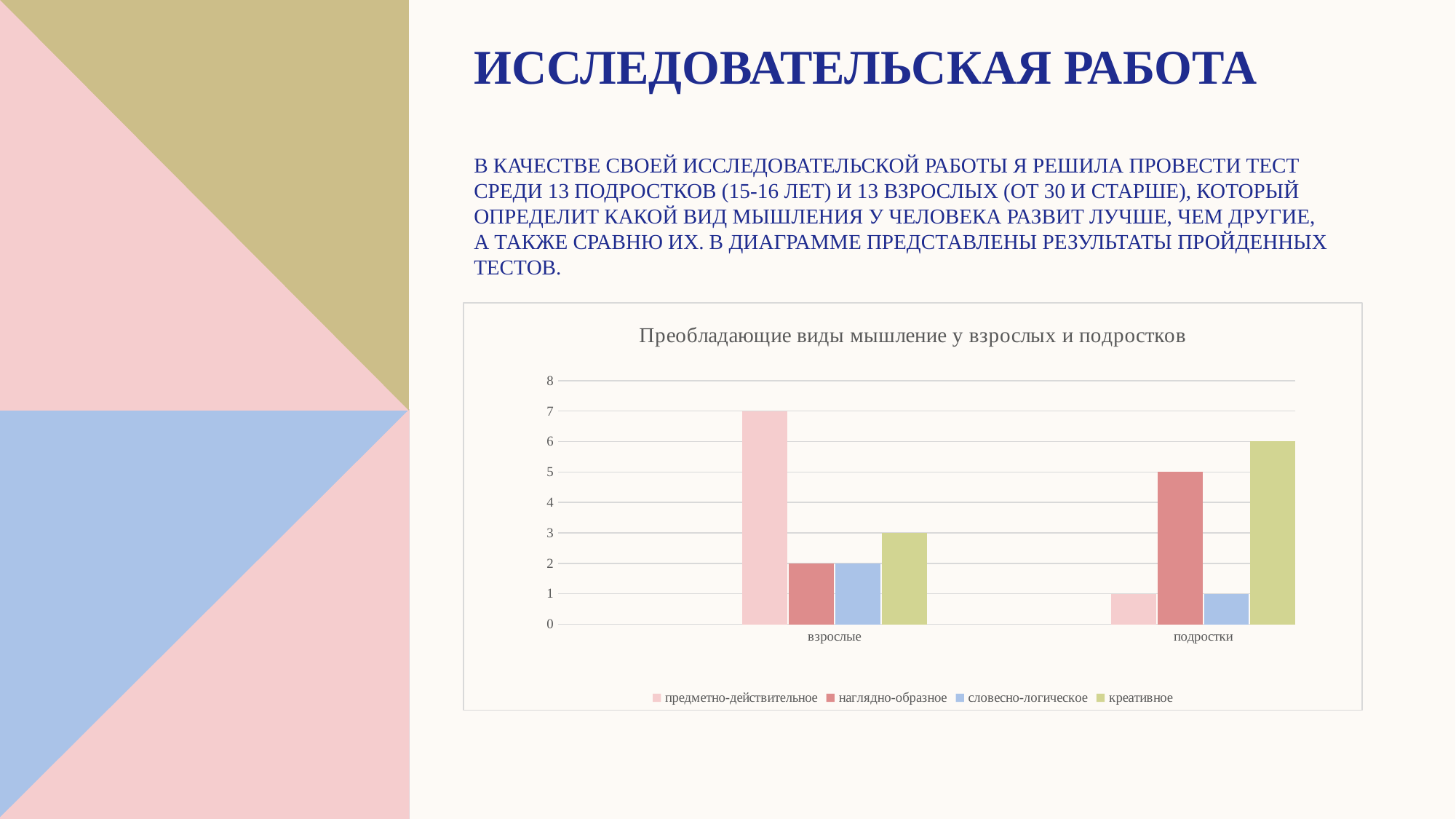
What is the difference between the предметно-действительное values for взрослые and подростки? 6 Which series has the highest value in the подростки category? креативное What kind of chart is shown on the slide? bar chart How many series does the chart legend list? 4 Which is larger: наглядно-образное for взрослые or наглядно-образное for подростки? подростки How many categories are shown on the x axis of the chart? 2 What is the value for креативное in the подростки category? 6 What is the title of the chart? Преобладающие виды мышление у взрослых и подростков What is the value for предметно-действительное in the взрослые category? 7 What is the value for креативное in the взрослые category? 3 Which series has the highest value in the взрослые category? предметно-действительное What is the value for наглядно-образное in the подростки category? 5